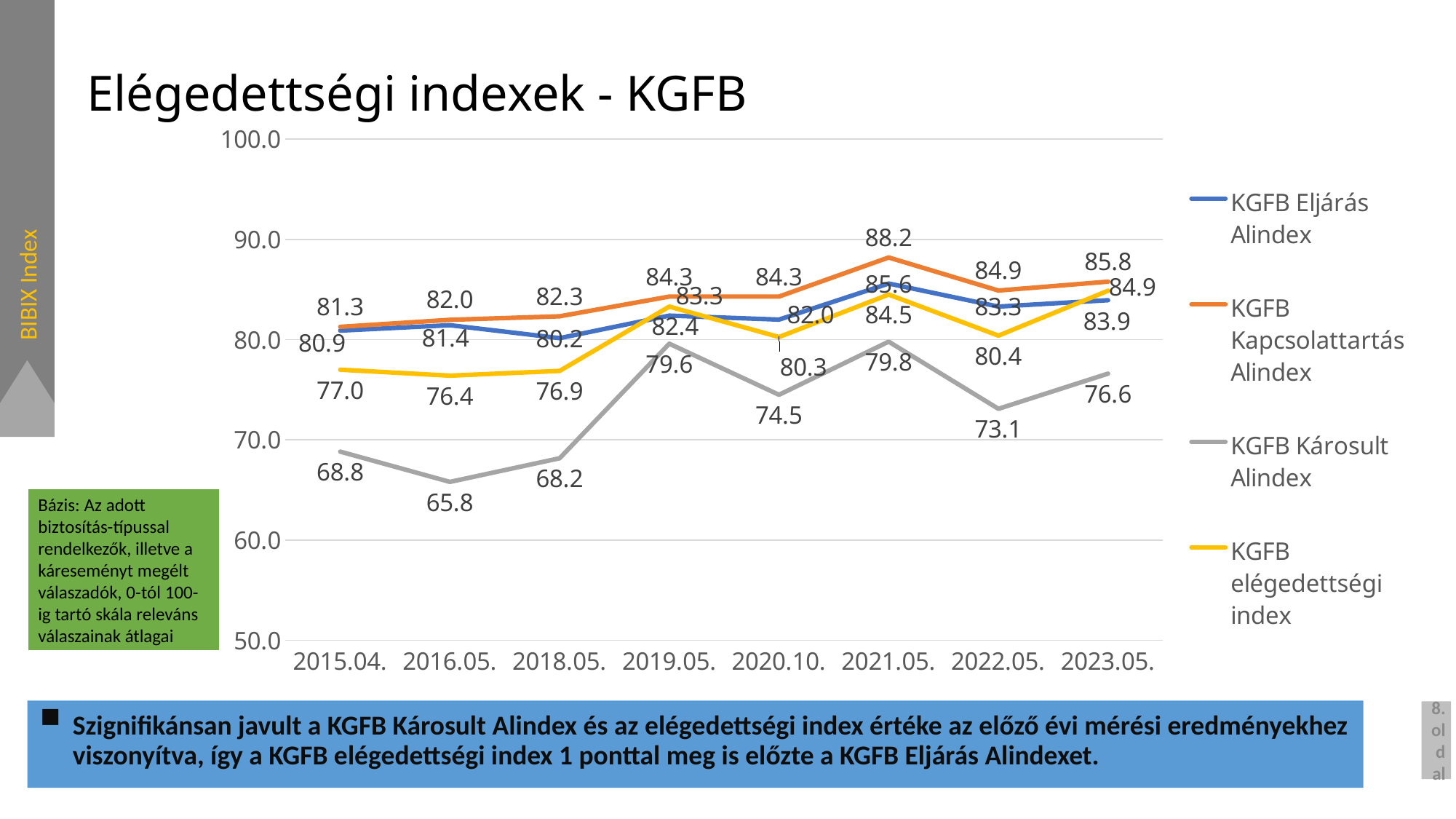
In which year does KGFB Kapcsolattartás Alindex reach its highest value? 2021.05. How many time points are shown on the x axis? 8 What is the value of KGFB Kapcsolattartás Alindex in 2021.05.? 88.2 What is the difference between KGFB elégedettségi index and KGFB Eljárás Alindex in 2023.05.? 1.0 In which year does KGFB Károsult Alindex reach its lowest value? 2016.05. What is the value of KGFB elégedettségi index in 2023.05.? 84.9 How many series does the legend list? 4 Is the value of KGFB Károsult Alindex in 2015.04. greater or less than 70.0? less Which series is shown in gray? KGFB Károsult Alindex What is the value of KGFB Károsult Alindex in 2016.05.? 65.8 Which is higher in 2022.05.: KGFB Eljárás Alindex or KGFB elégedettségi index? KGFB Eljárás Alindex What type of chart is shown on the slide? line chart